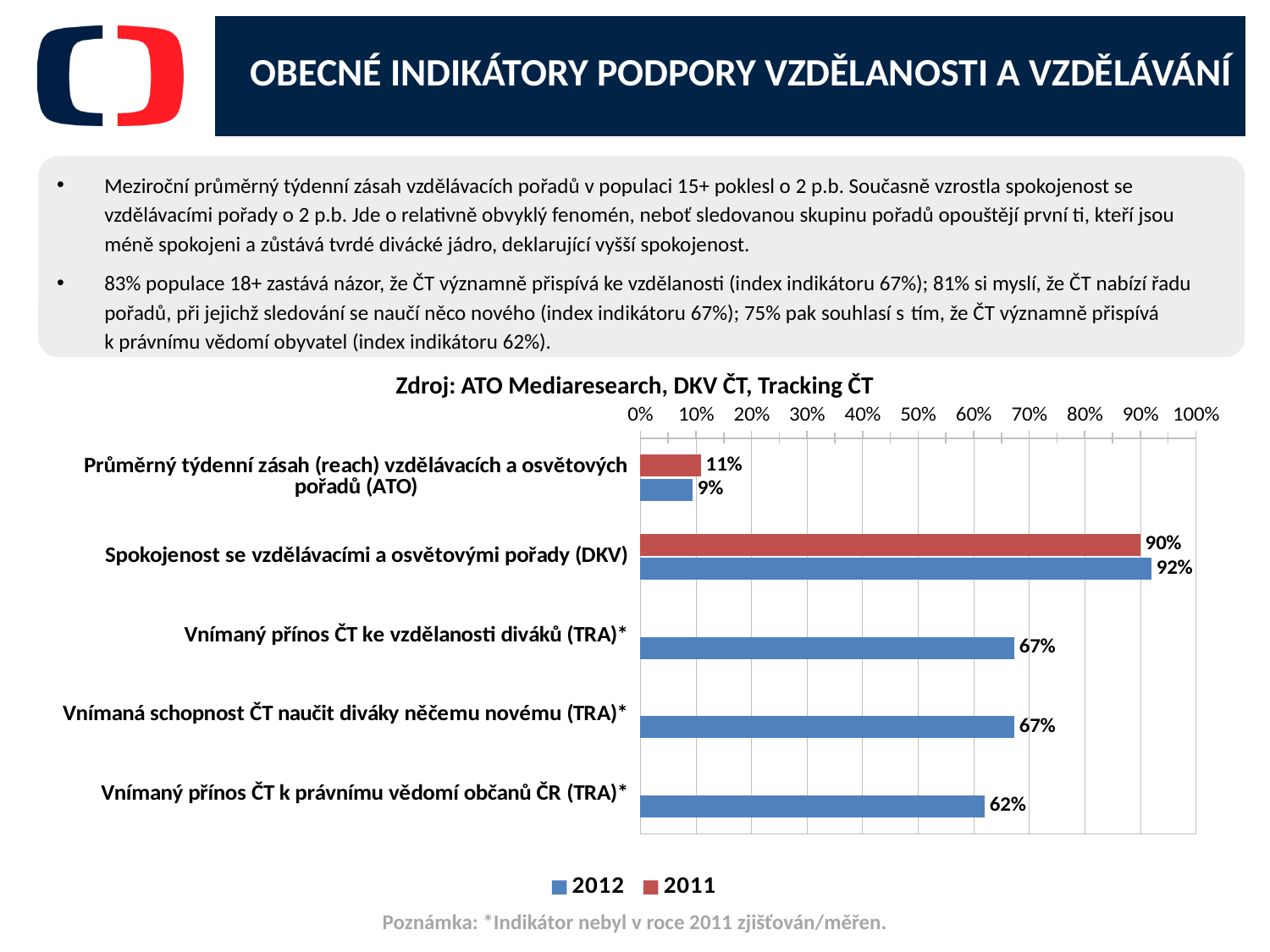
What type of chart is shown on the slide? bar chart For 'Průměrný týdenní zásah (reach) vzdělávacích a osvětových pořadů (ATO)', which year has the larger value, 2011 or 2012? 2011 What is the 2011 value for 'Průměrný týdenní zásah (reach) vzdělávacích a osvětových pořadů (ATO)'? 11% What is the 2012 value for 'Vnímaný přínos ČT k právnímu vědomí občanů ČR (TRA)*'? 62% Which colour represents the 2011 series in the chart? red How many categories are shown on the chart? 5 How many series does the chart legend list? 2 Which category has the highest 2012 value? Spokojenost se vzdělávacími a osvětovými pořady (DKV) Which category has the lowest 2012 value? Průměrný týdenní zásah (reach) vzdělávacích a osvětových pořadů (ATO) Is the 2012 value for 'Vnímaný přínos ČT ke vzdělanosti diváků (TRA)*' greater or less than 60%? greater What is the difference between the 2012 and 2011 values for 'Spokojenost se vzdělávacími a osvětovými pořady (DKV)'? 2% What is the 2012 value for 'Spokojenost se vzdělávacími a osvětovými pořady (DKV)'? 92%